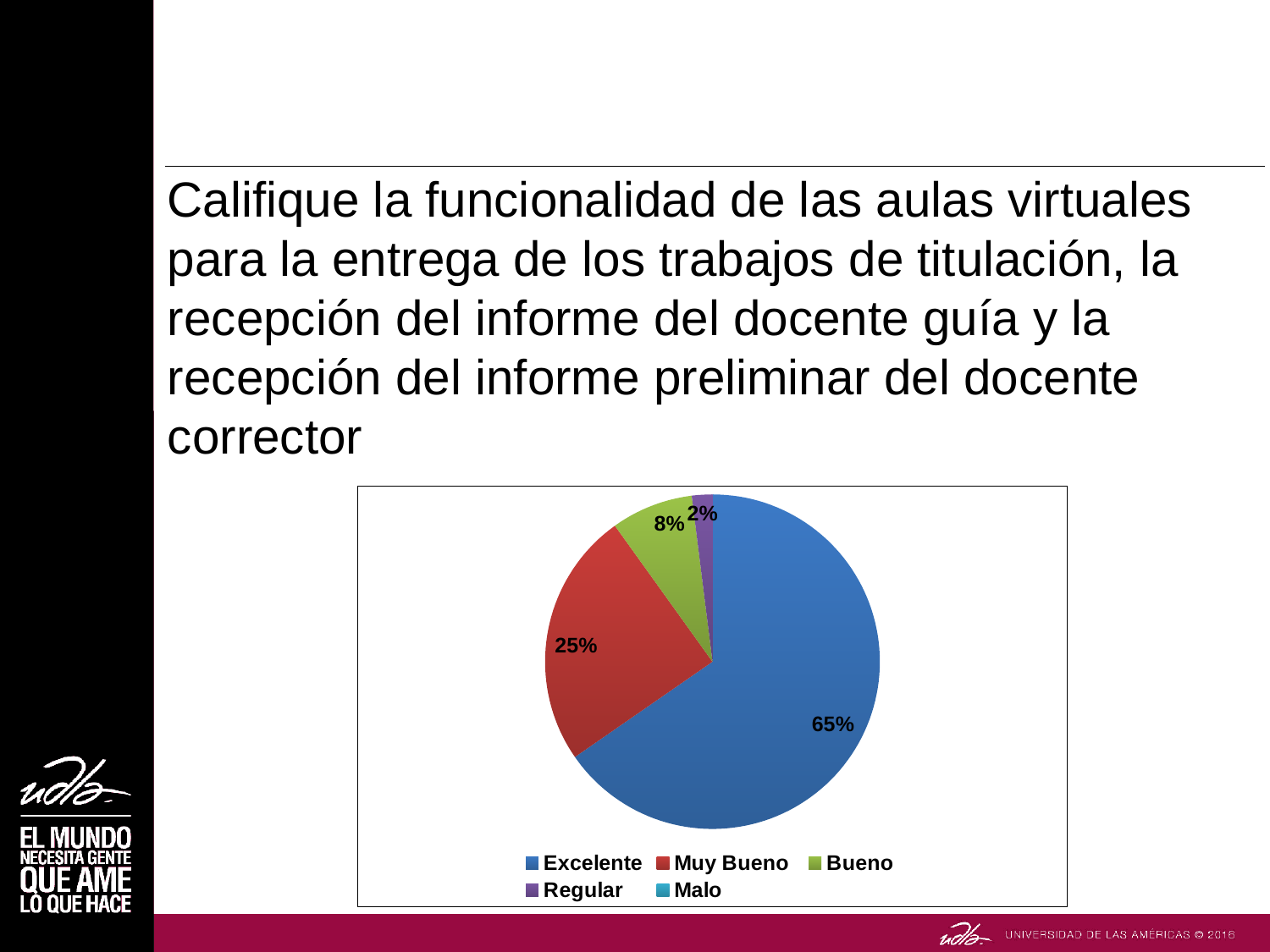
What colour is the Excelente slice? blue What percentage of the pie corresponds to Excelente? 65% What percentage of the pie corresponds to Bueno? 8% Which category has the largest share of the pie? Excelente What percentage of the pie corresponds to Muy Bueno? 25% Which labelled category has the smallest share of the pie? Regular What colour is the Muy Bueno slice? red How many categories does the legend list? 5 What type of chart is shown on the slide? pie chart What percentage of the pie corresponds to Regular? 2% Which is larger, the share for Bueno or the share for Regular? Bueno What is the difference between the Excelente and Muy Bueno shares? 40%